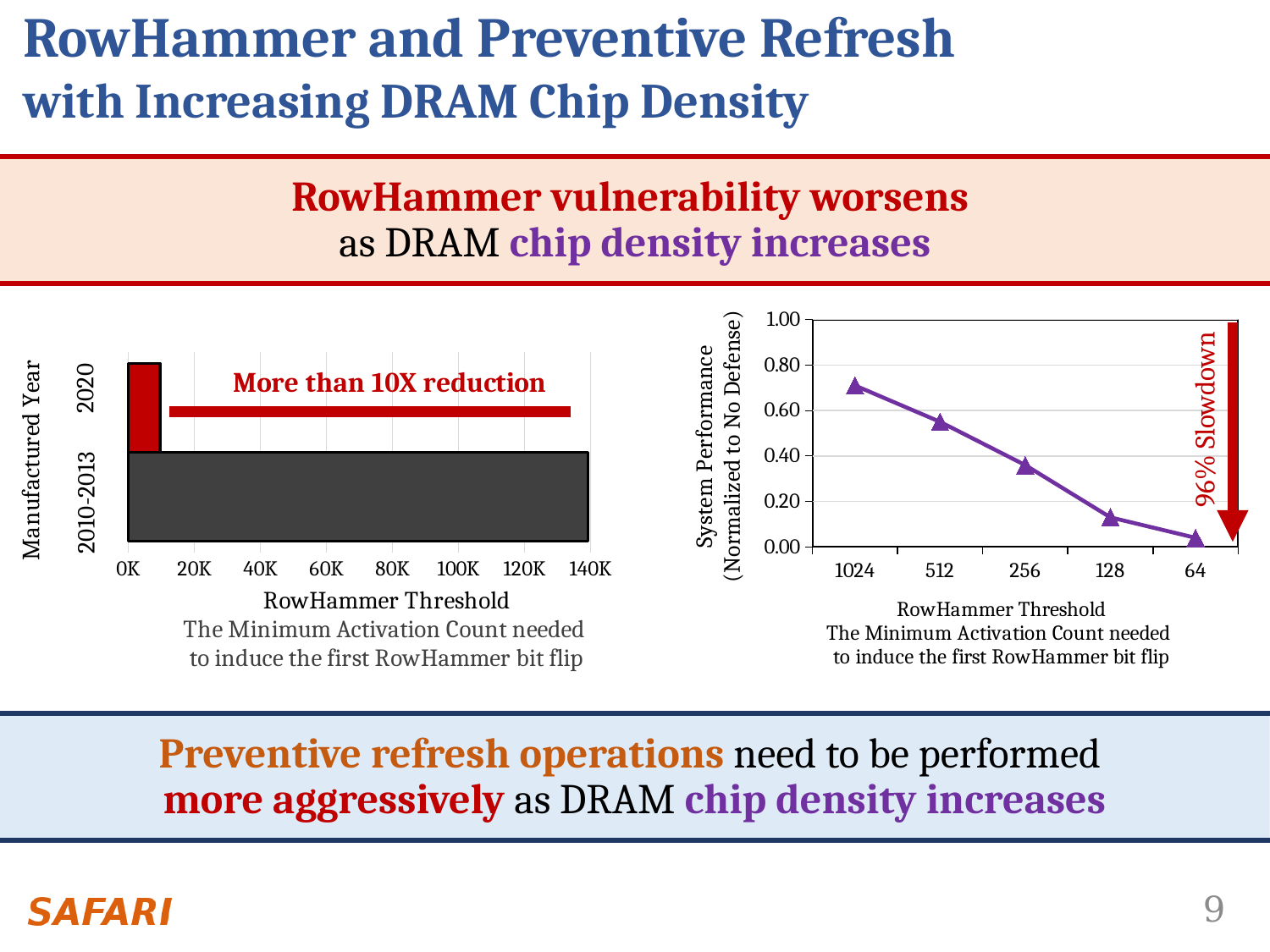
On the right chart, is the system performance at a RowHammer Threshold of 1024 greater or less than 0.60? greater On the left chart, is the RowHammer Threshold for 2020 greater or less than 20K? less On the left chart, what does the red annotation say about the reduction? More than 10X reduction On the right chart, does system performance rise or fall as the RowHammer Threshold goes from 1024 to 64? fall On the right chart, how many data points are plotted? 5 On the right chart, which RowHammer Threshold has the highest system performance? 1024 On the left chart, is the RowHammer Threshold for 2010-2013 greater or less than 120K? greater On the left chart, how many manufactured-year categories are shown? 2 On the left chart, what kind of chart is it? bar chart On the right chart, which RowHammer Threshold has the lowest system performance? 64 On the left chart, which manufactured-year category has the higher RowHammer Threshold? 2010-2013